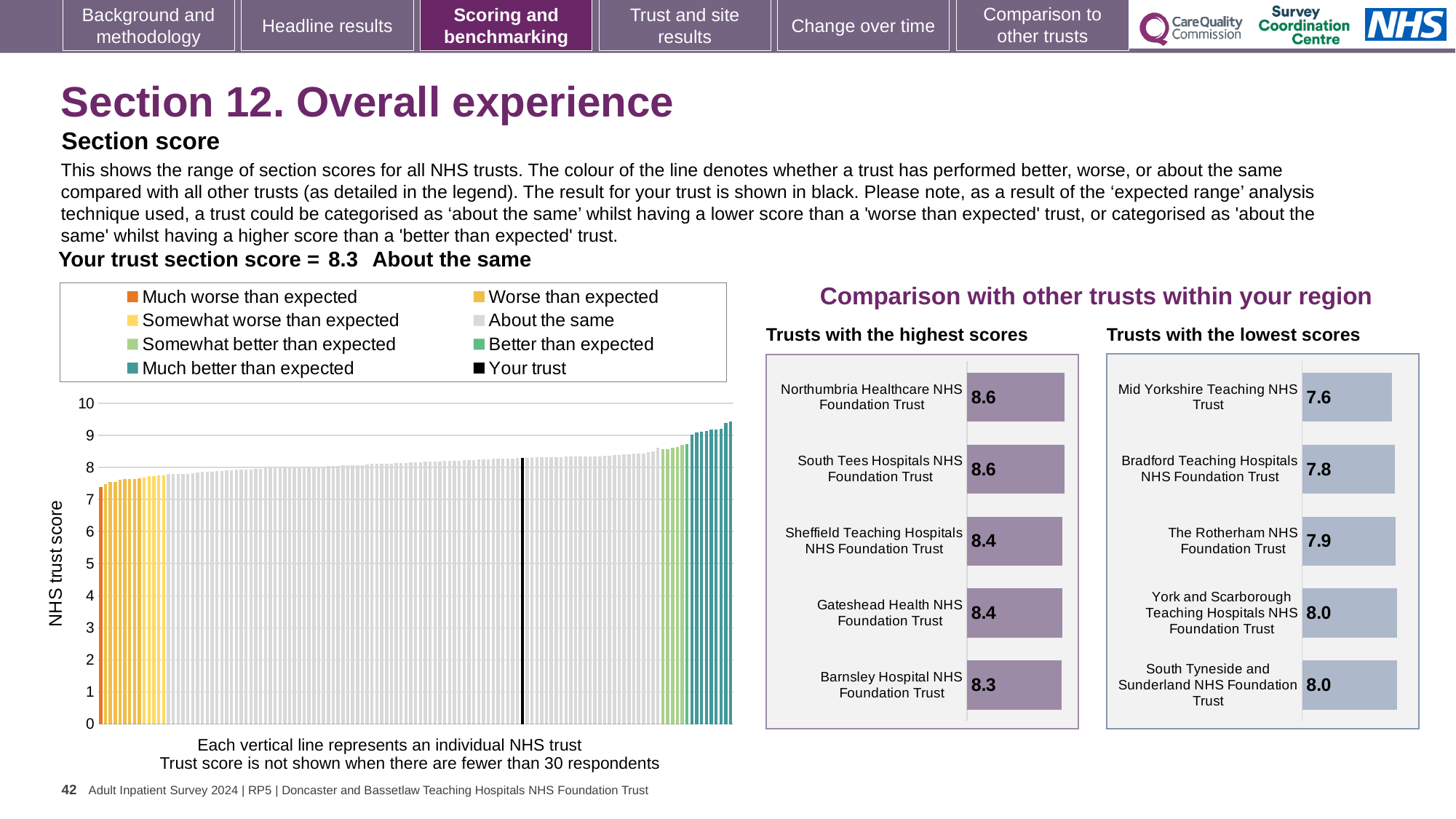
How many trusts are shown in the 'Trusts with the highest scores' chart? 5 In the 'Trusts with the highest scores' chart, what is the score for Sheffield Teaching Hospitals NHS Foundation Trust? 8.4 In the large chart on the left, do the trust scores rise or fall from left to right? Rise In the 'Trusts with the lowest scores' chart, what is the difference between the scores of Bradford Teaching Hospitals NHS Foundation Trust and Mid Yorkshire Teaching NHS Trust? 0.2 What kind of chart is the large chart on the left showing NHS trust scores? Bar chart In the 'Trusts with the lowest scores' chart, which trust has the lowest score? Mid Yorkshire Teaching NHS Trust In the 'Trusts with the highest scores' chart, which has the higher score: Northumbria Healthcare NHS Foundation Trust or Barnsley Hospital NHS Foundation Trust? Northumbria Healthcare NHS Foundation Trust In the 'Trusts with the highest scores' chart, what is the difference between the scores of Northumbria Healthcare NHS Foundation Trust and Barnsley Hospital NHS Foundation Trust? 0.3 How many entries does the legend of the large chart on the left list? 8 What is the y-axis label of the large chart on the left? NHS trust score What is the section score for your trust shown on the slide? 8.3 In the 'Trusts with the lowest scores' chart, what is the score for Mid Yorkshire Teaching NHS Trust? 7.6